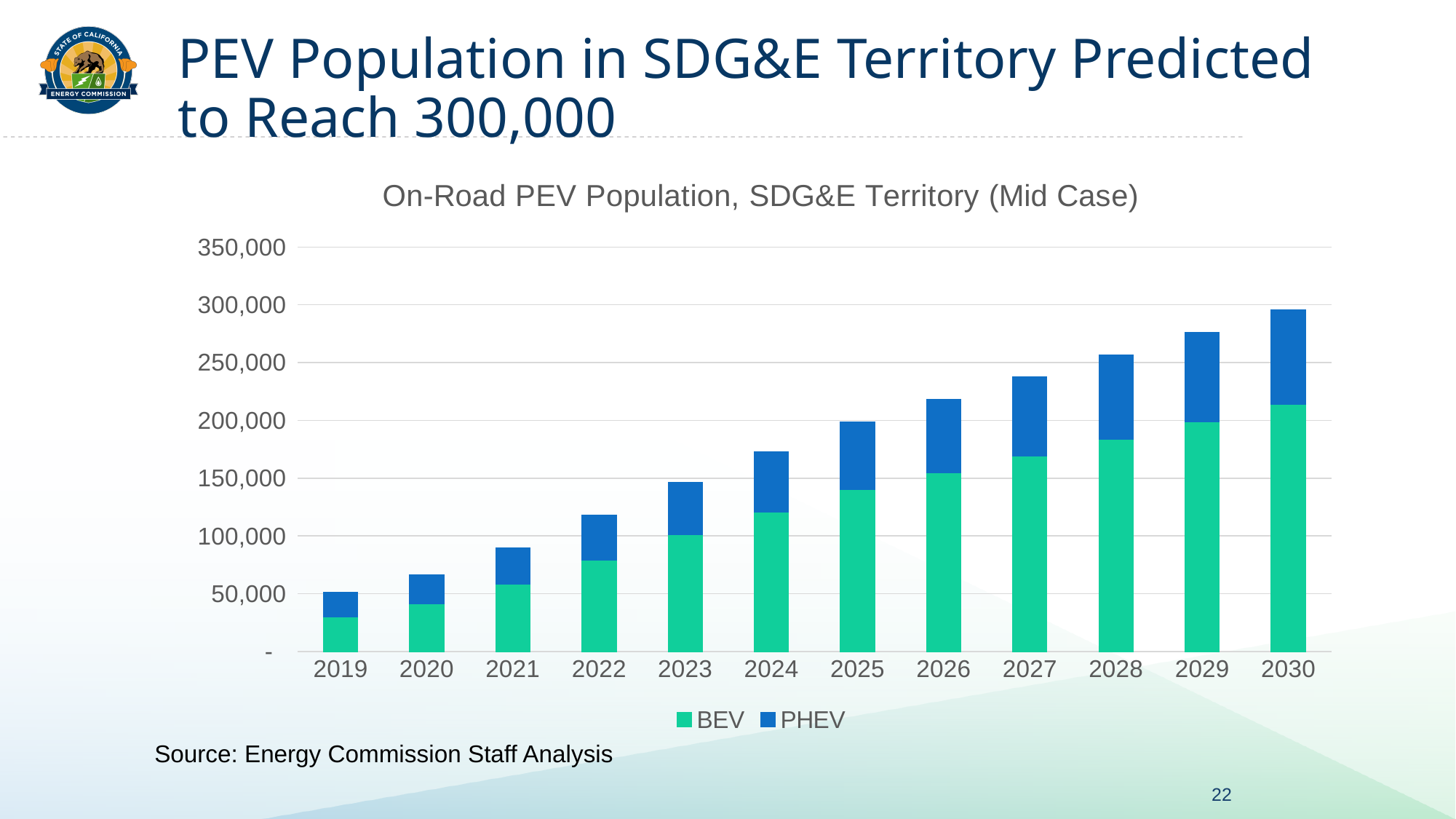
What is the title of the chart? On-Road PEV Population, SDG&E Territory (Mid Case) How many series does the legend list? 2 Is the total PEV population for 2019 greater or less than 100,000? less Is the total PEV population for 2030 greater or less than 250,000? greater Do the total PEV population values rise or fall from 2019 to 2030? Rise Which year has the lowest total PEV population? 2019 Which year has the highest total PEV population? 2030 Is the BEV value for 2030 greater or less than 200,000? greater Which series is shown in blue in the legend? PHEV How many years are shown on the x axis? 12 In 2030, which is larger, the BEV value or the PHEV value? BEV What kind of chart is shown on the slide? Stacked bar chart